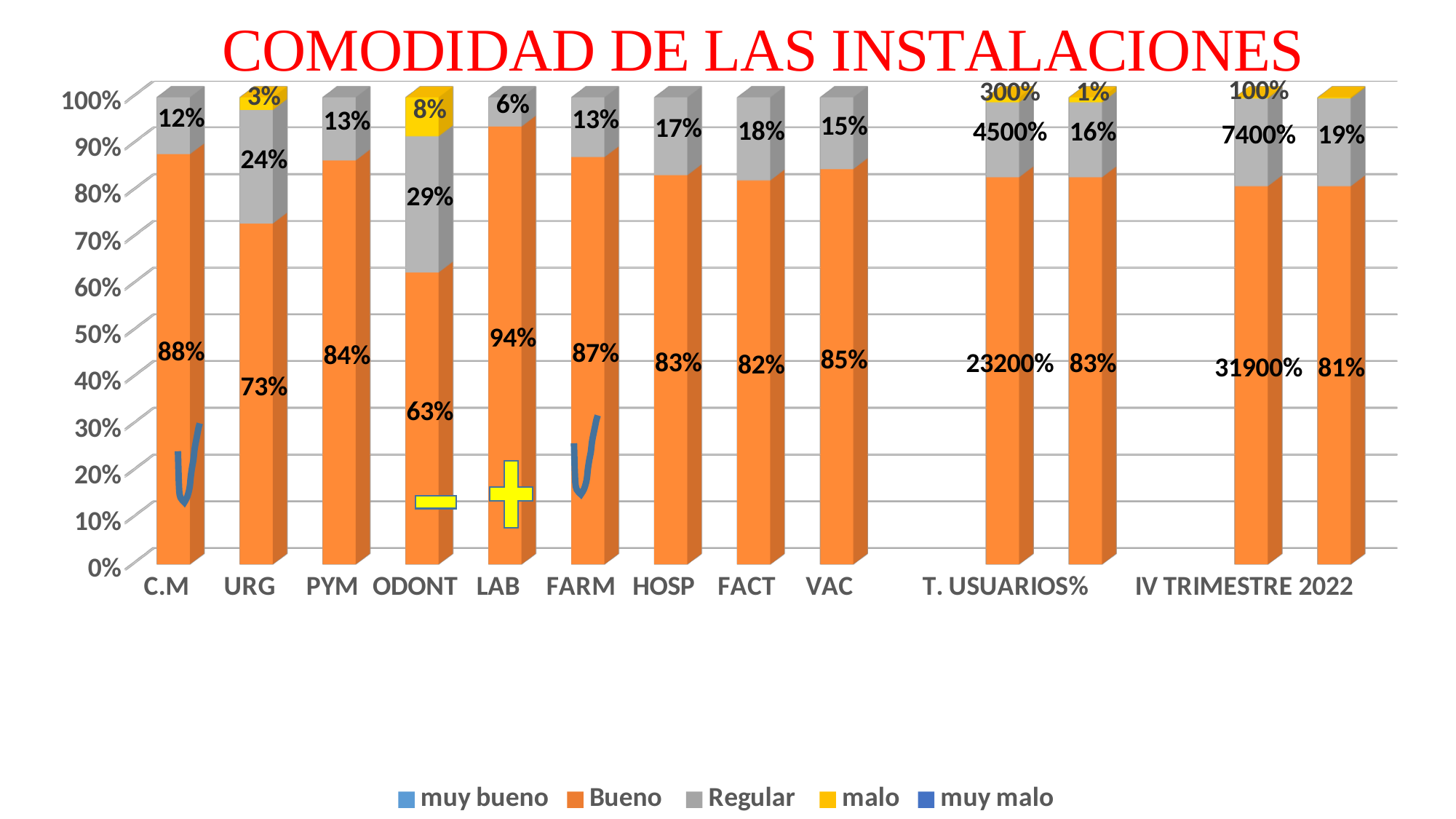
What is the difference between the Bueno values for C.M and URG? 15% What is the Bueno value for the second bar under IV TRIMESTRE 2022? 81% What is the title of the chart? COMODIDAD DE LAS INSTALACIONES Among C.M, URG, PYM, ODONT, LAB, FARM, HOSP, FACT and VAC, which category has the highest Bueno value? LAB How many series does the legend list? 5 Which has a larger Regular value, HOSP or VAC? HOSP What is the malo value for ODONT? 8% Among C.M, URG, PYM, ODONT, LAB, FARM, HOSP, FACT and VAC, which category has the lowest Bueno value? ODONT What kind of chart is shown on the slide? stacked bar chart What is the malo value for URG? 3% What is the Regular value for ODONT? 29% What is the Bueno value for LAB? 94%